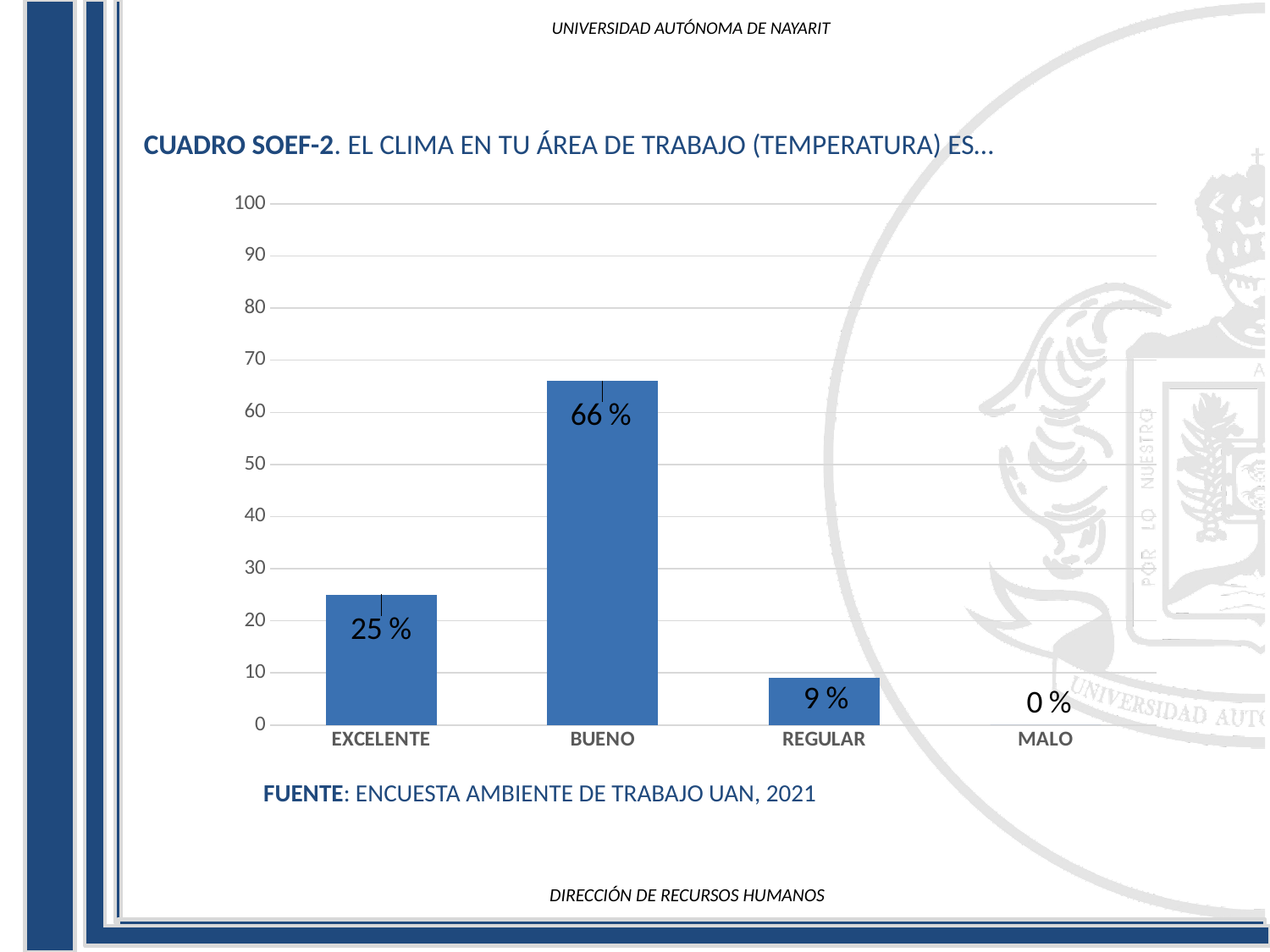
What is the value for BUENO? 66 % Which category has the highest value? BUENO What is the value for MALO? 0 % Which is larger, the value for EXCELENTE or the value for REGULAR? EXCELENTE What is the value for REGULAR? 9 % Is the value for BUENO greater or less than 60? greater What kind of chart is shown on the slide? bar chart What source is cited below the chart? ENCUESTA AMBIENTE DE TRABAJO UAN, 2021 Which category has the lowest value? MALO What is the difference between the values for BUENO and EXCELENTE? 41 % What is the value for EXCELENTE? 25 % How many categories are shown on the x axis? 4